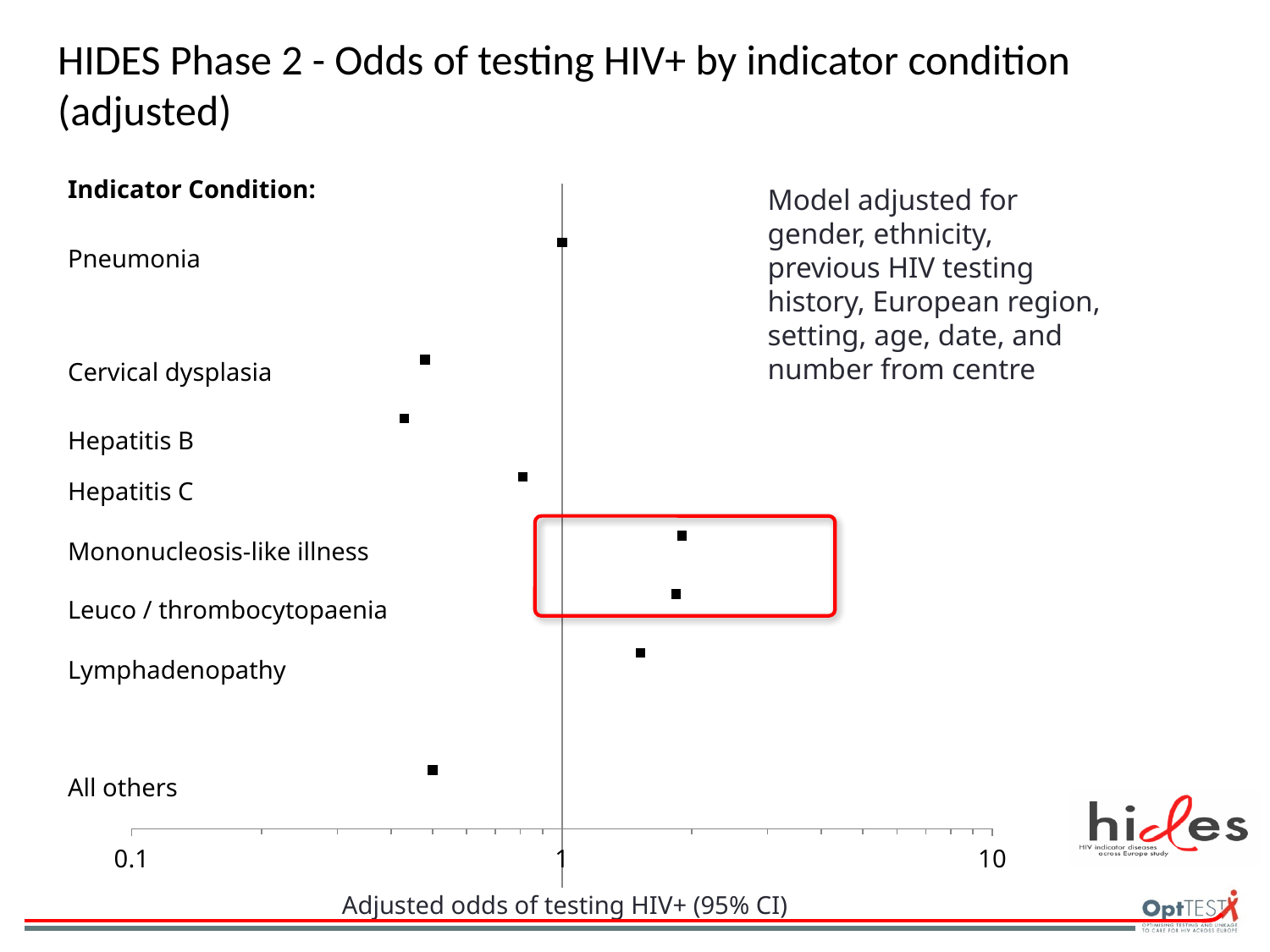
Which has the higher adjusted odds of testing HIV+: Hepatitis C or Mononucleosis-like illness? Mononucleosis-like illness What is the label of the horizontal axis? Adjusted odds of testing HIV+ (95% CI) Which has the higher adjusted odds of testing HIV+: Hepatitis B or Lymphadenopathy? Lymphadenopathy Is the adjusted odds value for Cervical dysplasia greater or less than 1? less Is the adjusted odds value for Lymphadenopathy greater or less than 1? greater Is the adjusted odds value for Mononucleosis-like illness greater or less than 1? greater What kind of chart is shown on the slide? scatter (dot) plot What are the minimum and maximum tick values shown on the horizontal axis? 0.1 and 10 How many indicator conditions are plotted on the chart? 8 Which indicator condition has the lowest adjusted odds of testing HIV+? Hepatitis B